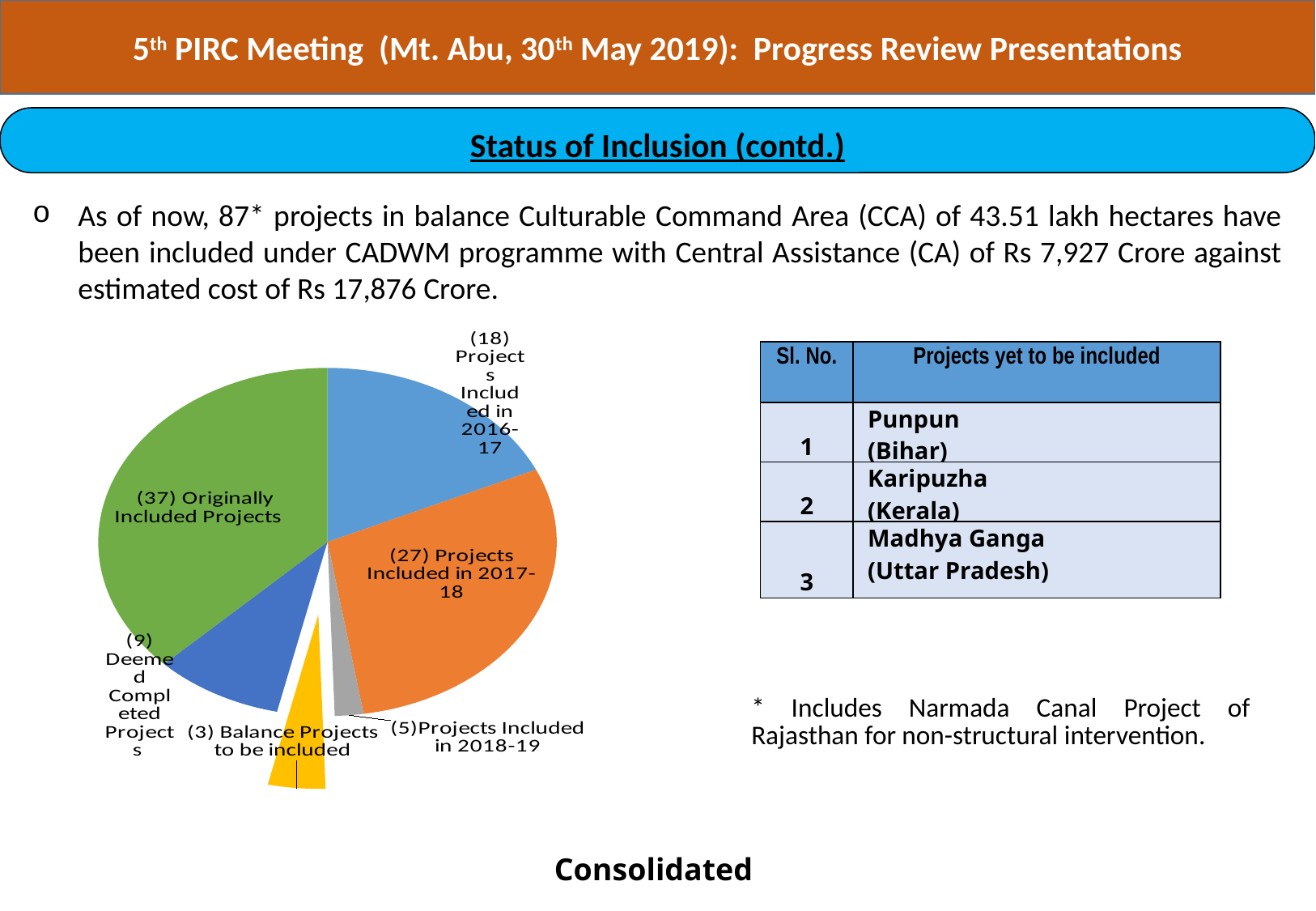
What is the difference between the number of projects included in 2017-18 and the number included in 2016-17? 9 How many projects were included in 2016-17 according to the pie chart? 18 What type of chart is shown on the slide? pie chart How many Balance Projects to be included does the pie chart show? 3 Which is larger: the number of projects included in 2018-19 or the number of Deemed Completed Projects? Deemed Completed Projects How many Originally Included Projects does the pie chart show? 37 How many Deemed Completed Projects does the pie chart show? 9 How many slices does the pie chart have? 6 Which category has the largest slice in the pie chart? (37) Originally Included Projects How many projects were included in 2017-18 according to the pie chart? 27 What is the caption printed below the pie chart? Consolidated